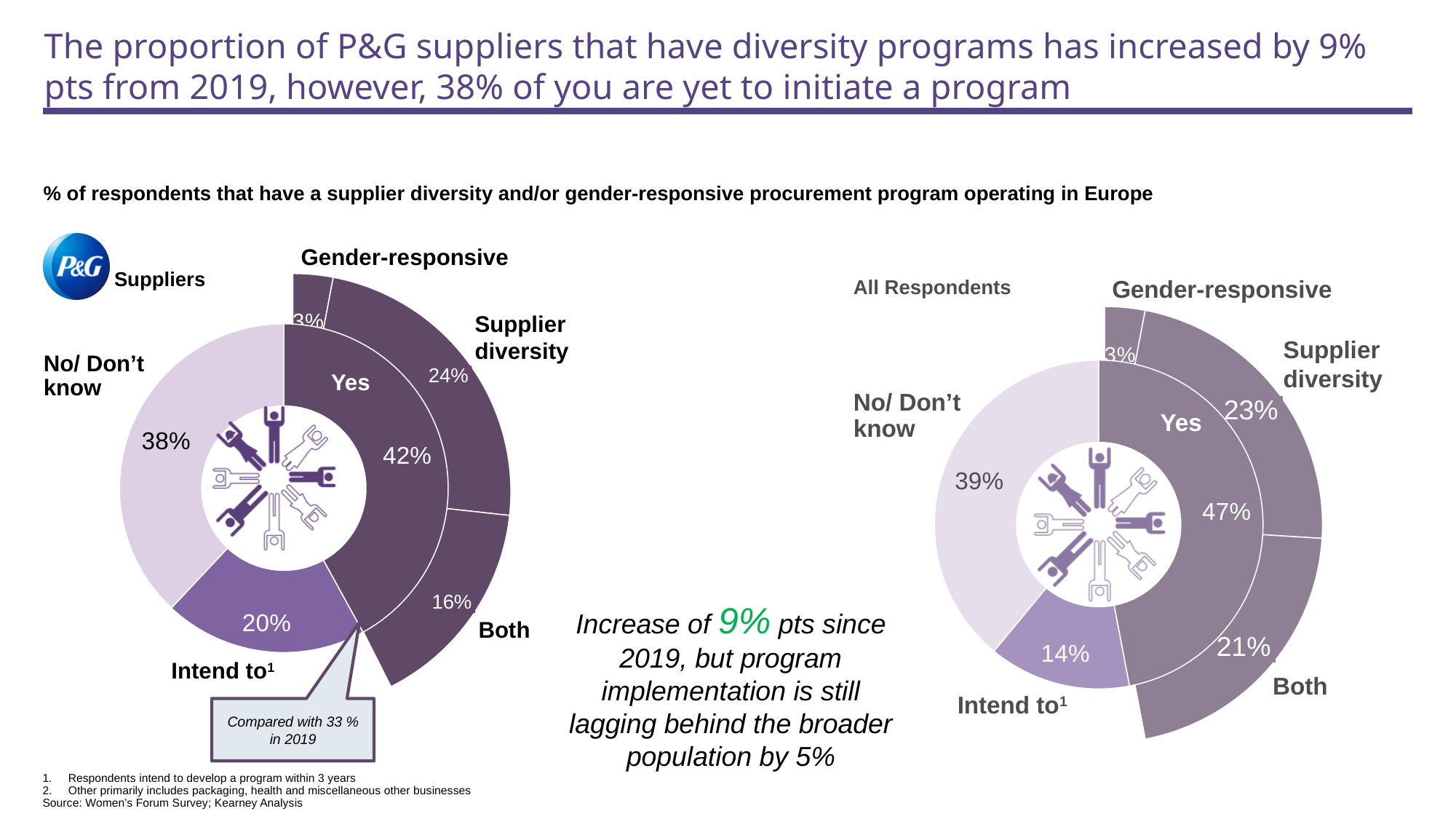
In the P&G Suppliers chart, which of the three program types (Gender-responsive, Supplier diversity, Both) has the smallest share? Gender-responsive Which is larger: the Intend to share in the P&G Suppliers chart or the Intend to share in the All Respondents chart? P&G Suppliers In the P&G Suppliers chart, what is the difference between the Supplier diversity share and the Both share? 8% In the P&G Suppliers chart, what percentage of respondents answered Yes? 42% In the All Respondents chart, what percentage have both a supplier diversity and a gender-responsive program? 21% What is the difference between the Yes share in the All Respondents chart and the Yes share in the P&G Suppliers chart? 5% What type of chart is used for the P&G Suppliers data? Donut (pie) chart In the All Respondents chart, which inner-ring category (Yes, Intend to, No/ Don't know) has the largest share? Yes In the All Respondents chart, what percentage of respondents intend to develop a program? 14% According to the callout on the P&G Suppliers chart, what was the Yes share in 2019? 33% How many inner-ring categories (Yes, Intend to, No/ Don't know) does the All Respondents chart show? 3 In the P&G Suppliers chart, what percentage of respondents answered No/ Don't know? 38%